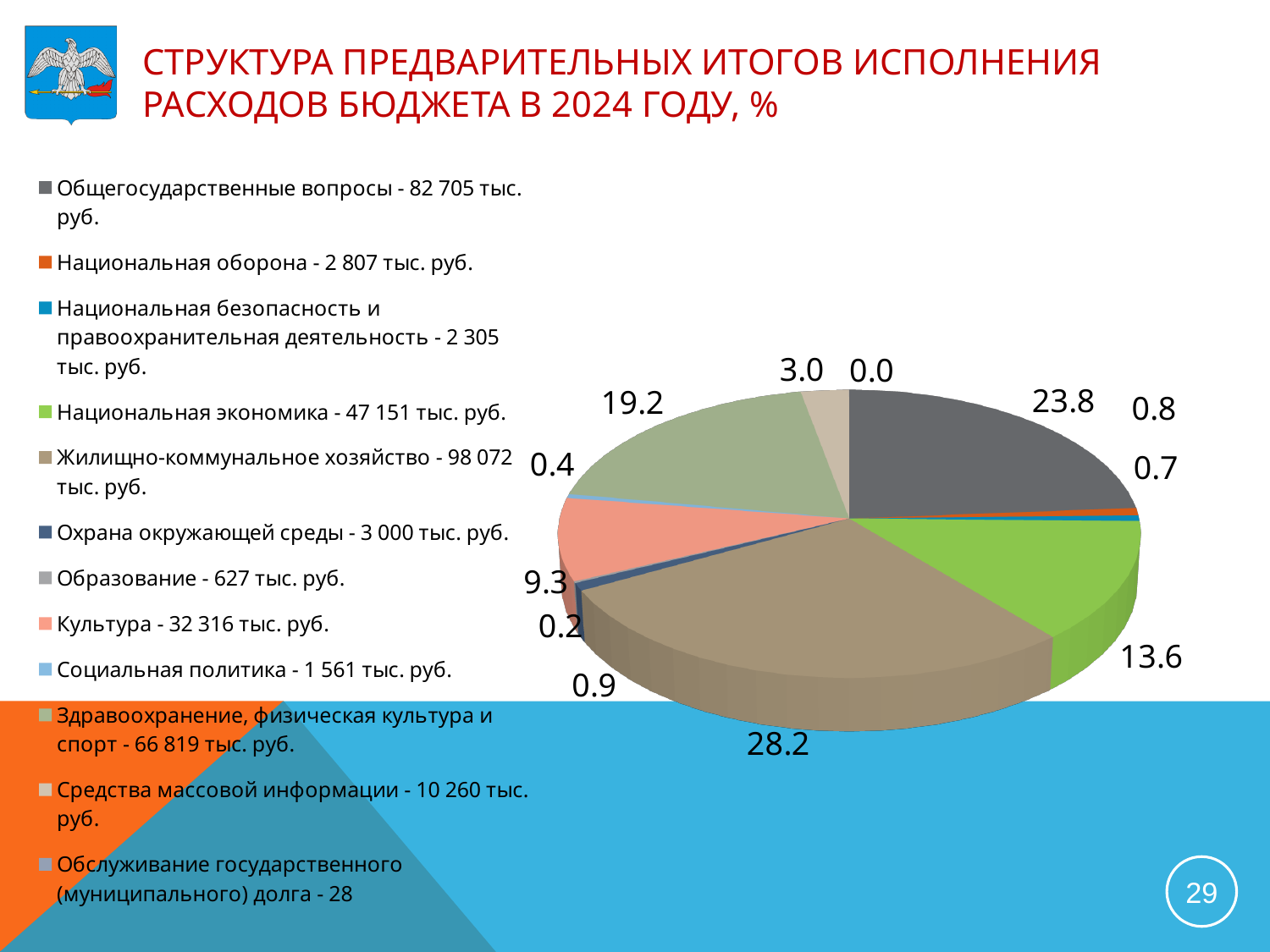
What is the percentage shown for Общегосударственные вопросы? 23.8 How many categories does the legend of the pie chart list? 12 What is the difference in percentage points between Жилищно-коммунальное хозяйство and Общегосударственные вопросы? 4.4 What is the percentage shown for Здравоохранение, физическая культура и спорт? 19.2 What is the title of the slide's chart? СТРУКТУРА ПРЕДВАРИТЕЛЬНЫХ ИТОГОВ ИСПОЛНЕНИЯ РАСХОДОВ БЮДЖЕТА В 2024 ГОДУ, % What is the percentage shown for Жилищно-коммунальное хозяйство? 28.2 What kind of chart is shown on the slide? pie chart Which has a larger share: Национальная экономика or Культура? Национальная экономика What is the percentage shown for Культура? 9.3 What is the percentage shown for Национальная экономика? 13.6 Which category has the largest share of the pie chart? Жилищно-коммунальное хозяйство What is the percentage shown for Средства массовой информации? 3.0